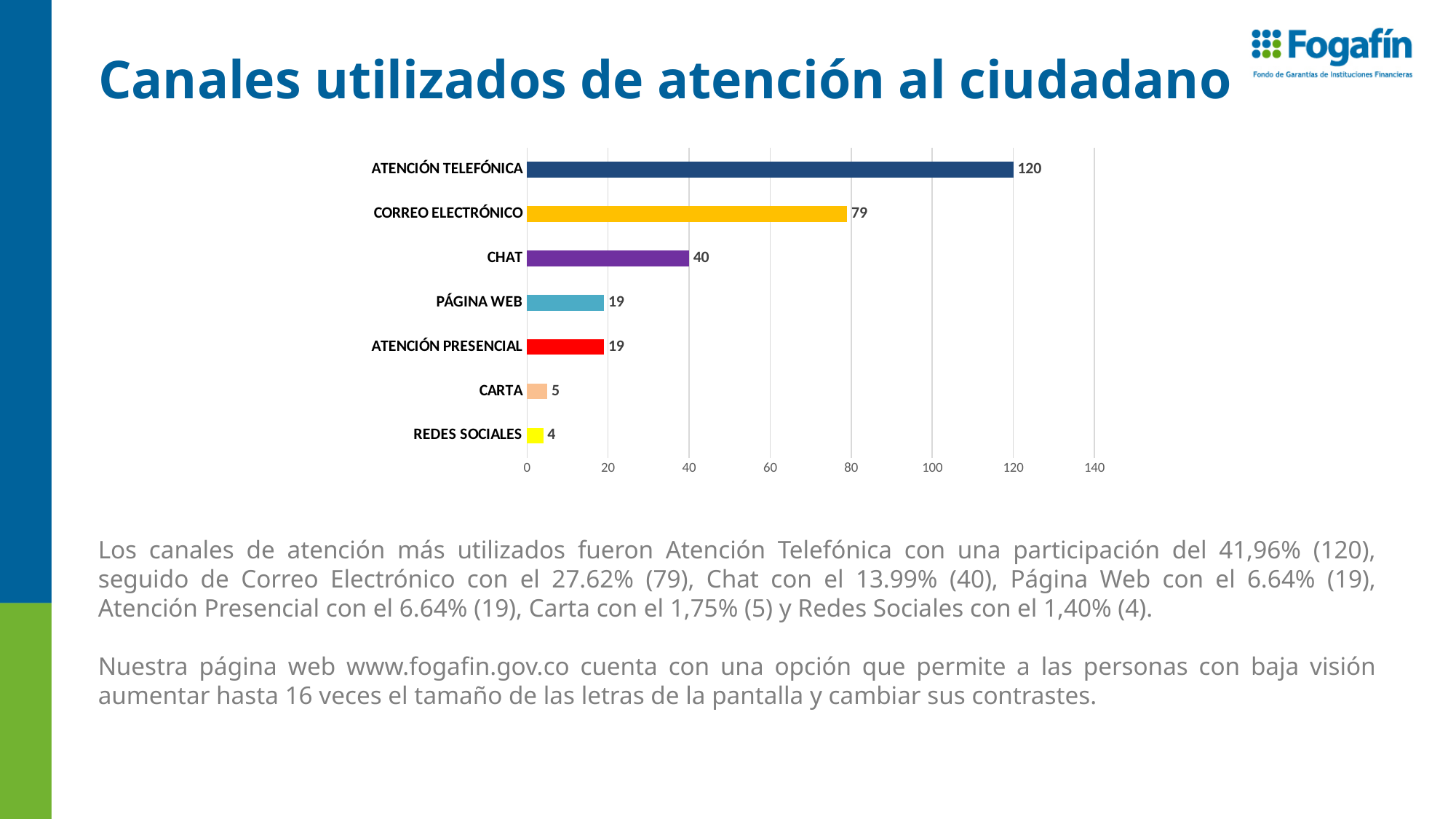
What is the value for CHAT? 40 What is the difference between the values for ATENCIÓN TELEFÓNICA and CORREO ELECTRÓNICO? 41 What is the value for CORREO ELECTRÓNICO? 79 What is the value for ATENCIÓN TELEFÓNICA? 120 Which is larger, the value for CHAT or the value for PÁGINA WEB? CHAT What is the value for CARTA? 5 What colour is the bar for ATENCIÓN PRESENCIAL? red Which category has the highest value? ATENCIÓN TELEFÓNICA How many categories are shown in the chart? 7 What kind of chart is shown on the slide? bar chart Which category has the lowest value? REDES SOCIALES Is the value for CORREO ELECTRÓNICO greater or less than 60? greater